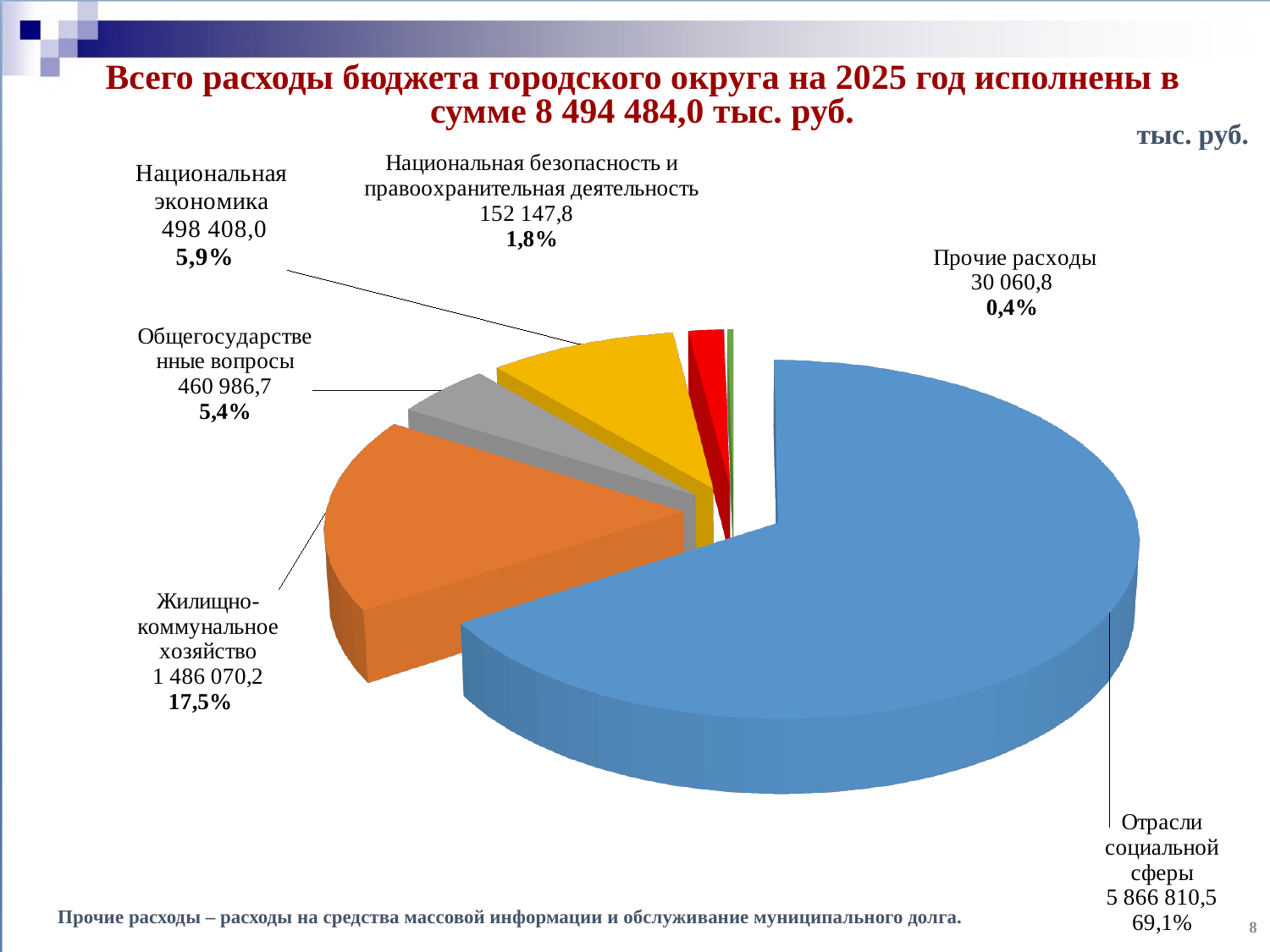
What is the value for Национальная безопасность и правоохранительная деятельность? 152 147,8 What is the value for Отрасли социальной сферы? 5 866 810,5 What unit is indicated in the top right corner of the chart? тыс. руб. What share of the pie does Жилищно-коммунальное хозяйство represent? 17,5% How many slices does the pie chart have? 6 Which category has the largest slice of the pie? Отрасли социальной сферы What is the difference between the values for Национальная экономика and Общегосударственные вопросы? 37 421,3 What share of the pie does Прочие расходы represent? 0,4% What kind of chart is shown on the slide? pie chart By how many percentage points does the share of Отрасли социальной сферы exceed the share of Жилищно-коммунальное хозяйство? 51,6% Which category has the smallest slice of the pie? Прочие расходы Which is larger, Национальная экономика or Общегосударственные вопросы? Национальная экономика